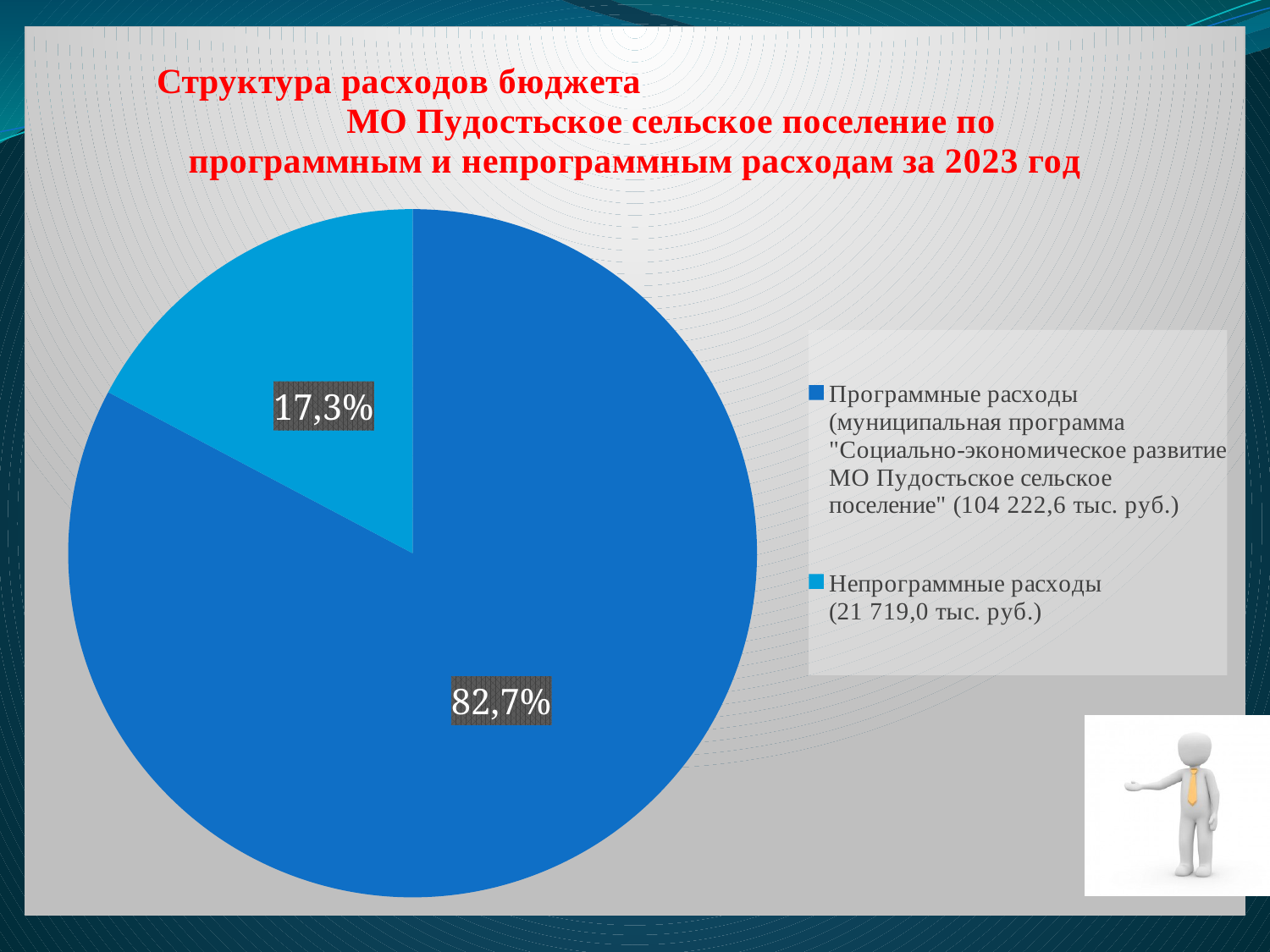
How many entries does the legend list? 2 Which category has the largest slice of the pie? Программные расходы What kind of chart is shown on the slide? pie chart How many slices does the pie chart have? 2 Which year does the chart title say the expenditure structure refers to? 2023 What is the difference in percentage points between the Программные расходы slice and the Непрограммные расходы slice? 65,4 What amount in тыс. руб. is given in the legend for Непрограммные расходы? 21 719,0 тыс. руб. What amount in тыс. руб. is given in the legend for Программные расходы? 104 222,6 тыс. руб. What share of the pie does Программные расходы take? 82,7% What share of the pie does Непрограммные расходы take? 17,3% Which slice is larger: Программные расходы or Непрограммные расходы? Программные расходы Which category has the smallest slice of the pie? Непрограммные расходы